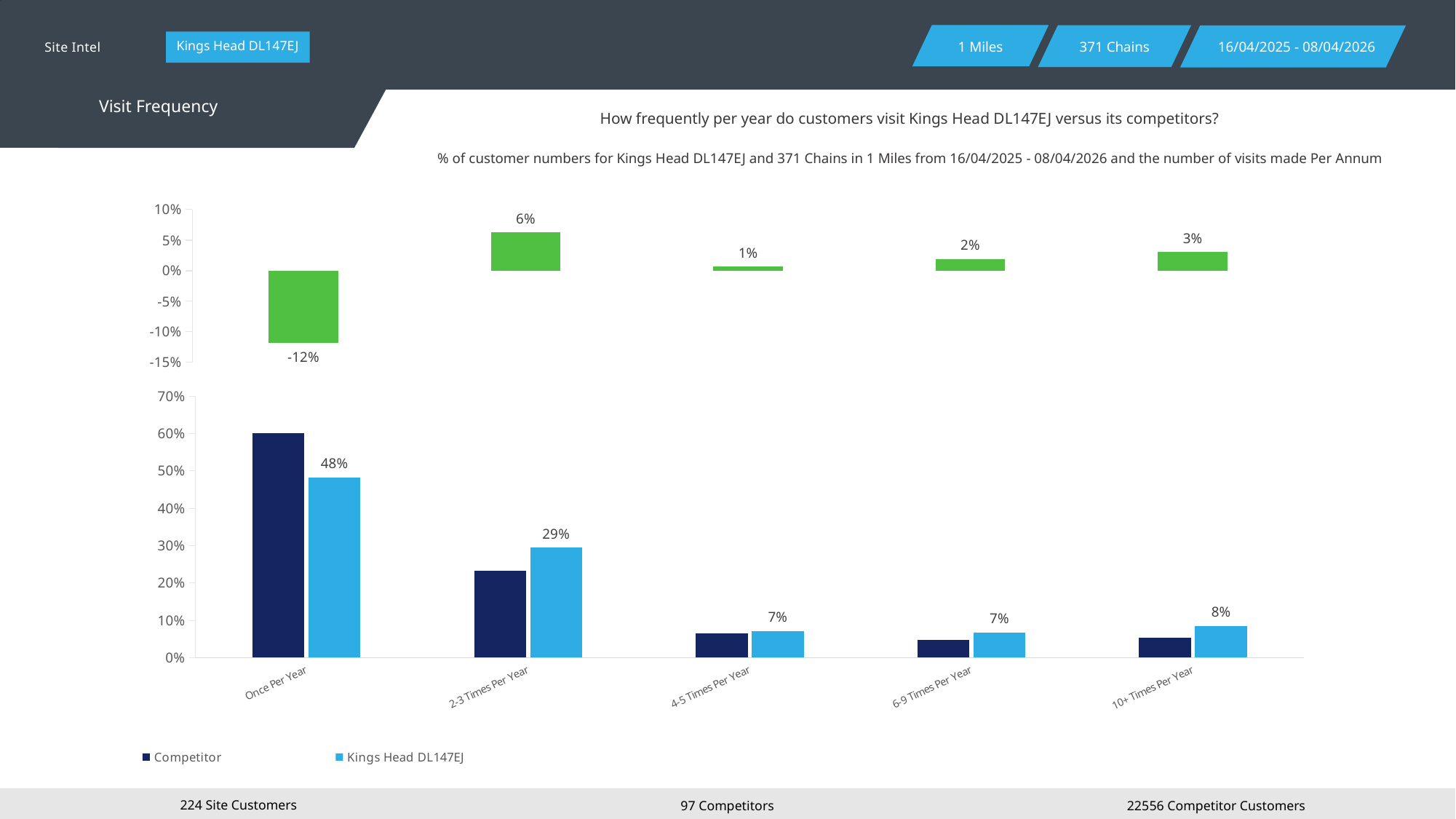
How many series does the legend of the bottom chart list? 2 In the bottom chart, for Once Per Year, which series has the larger value: Competitor or Kings Head DL147EJ? Competitor In the bottom chart, what is the value for Kings Head DL147EJ for Once Per Year? 48% In the top chart, which category has the lowest value? Once Per Year In the bottom chart, is the Competitor value for Once Per Year greater or less than 50%? greater In the bottom chart, what is the value for Kings Head DL147EJ for 2-3 Times Per Year? 29% What kind of chart is the bottom chart? bar chart In the top chart, what is the value shown for 2-3 Times Per Year? 6% In the bottom chart, is the Competitor value for 2-3 Times Per Year greater or less than 30%? less In the top chart, what is the value shown for Once Per Year? -12% How many categories are shown on the x axis of the bottom chart? 5 In the top chart, which category has the highest value? 2-3 Times Per Year